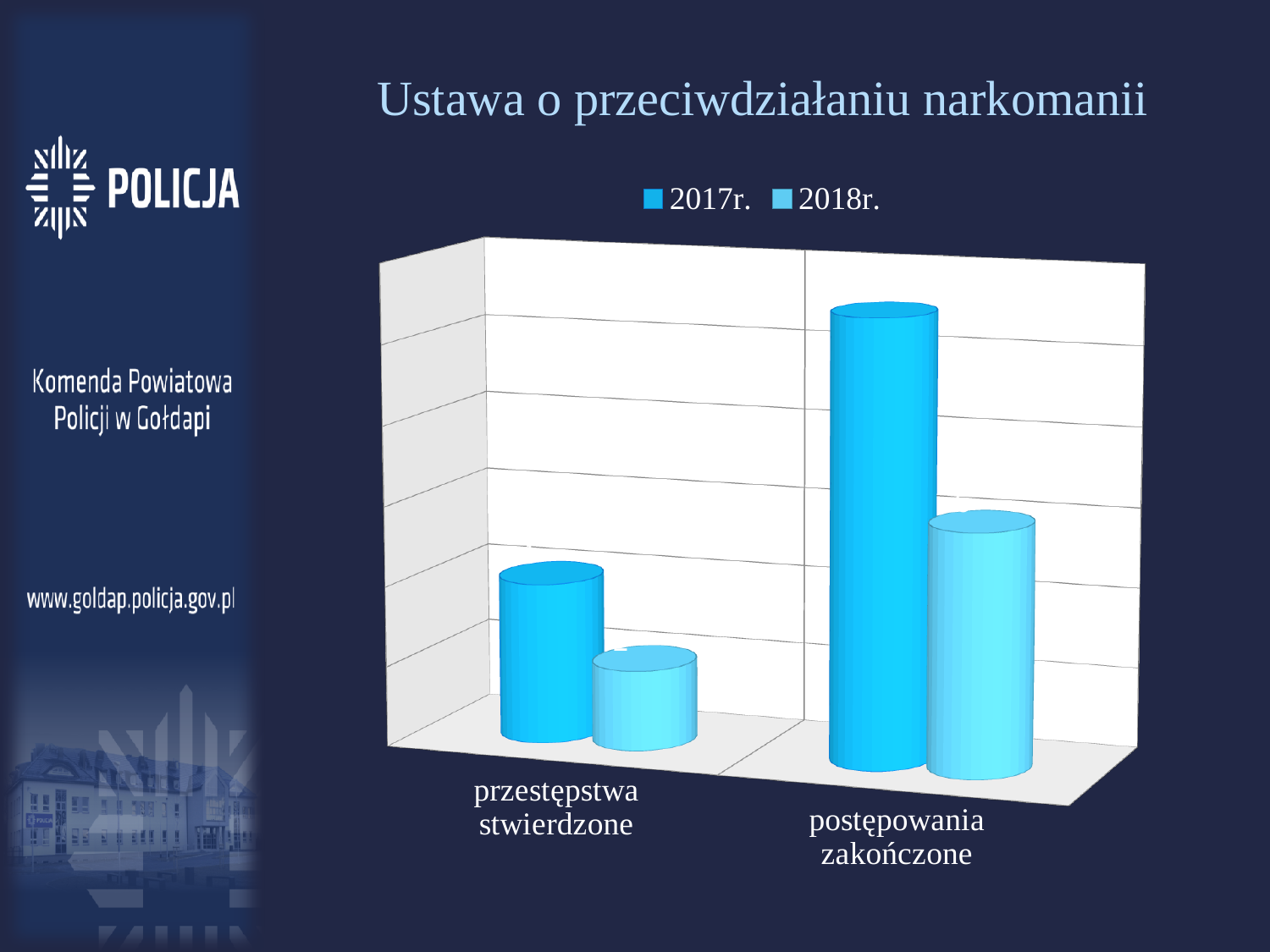
For 'postępowania zakończone', which year has the larger value, 2017r. or 2018r.? 2017r. How many series does the legend list? 2 Which bar is the shortest in the chart? 2018r. for przestępstwa stwierdzone Which category has the higher value for 2018r., 'przestępstwa stwierdzone' or 'postępowania zakończone'? postępowania zakończone For 'przestępstwa stwierdzone', which year has the larger value, 2017r. or 2018r.? 2017r. What kind of chart is shown on the slide? bar chart Which series are listed in the legend? 2017r. and 2018r. How many categories are shown on the x axis? 2 For the 2018r. series, do the values rise or fall from 'przestępstwa stwierdzone' to 'postępowania zakończone'? rise What is the title of the chart? Ustawa o przeciwdziałaniu narkomanii Which bar is the tallest in the chart? 2017r. for postępowania zakończone For the 2017r. series, do the values rise or fall from 'przestępstwa stwierdzone' to 'postępowania zakończone'? rise